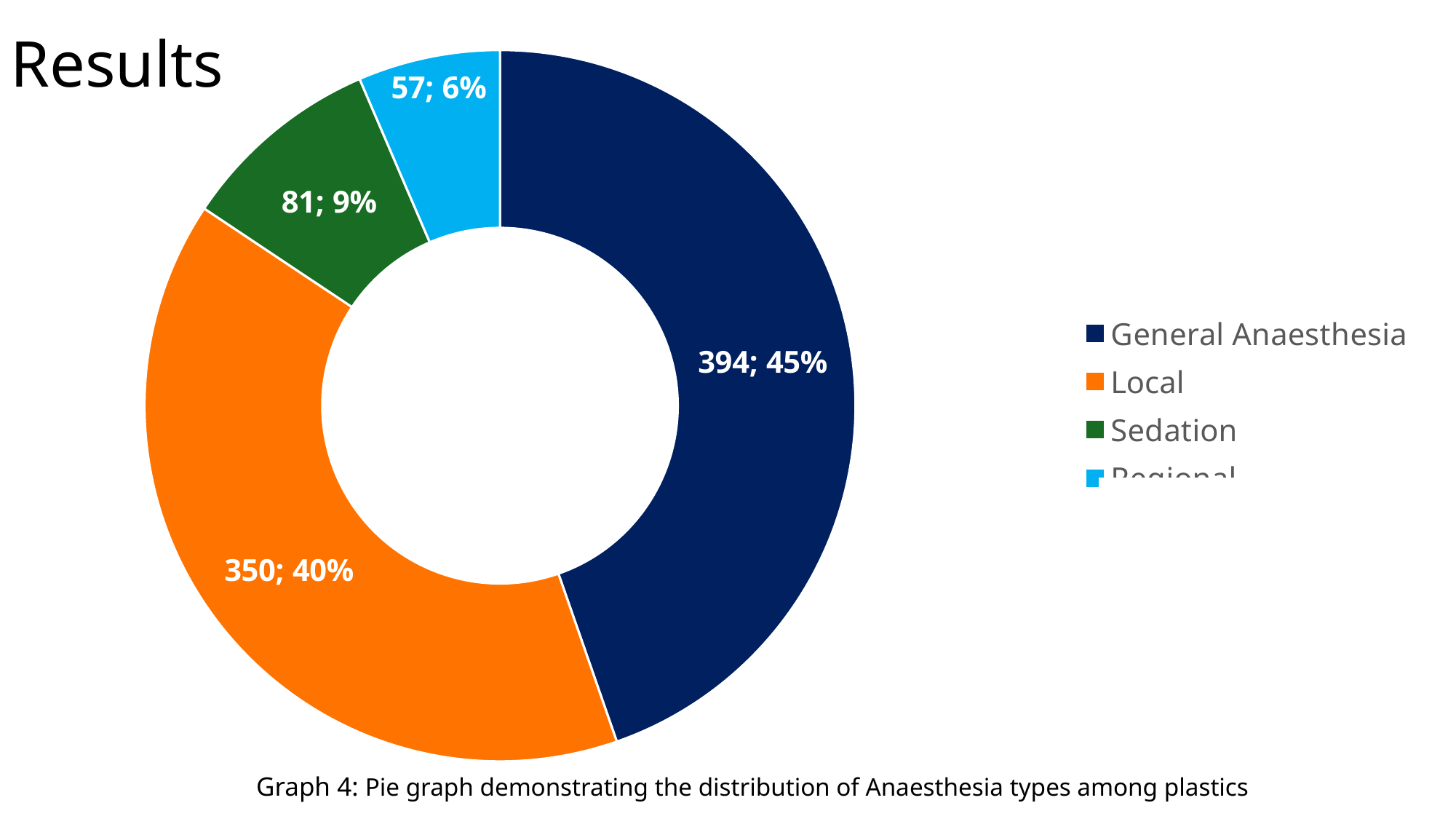
Which is larger, the value for Local or the value for Sedation? Local What is the caption given below the chart? Graph 4: Pie graph demonstrating the distribution of Anaesthesia types among plastics What is the smallest value labelled on the chart? 57 Which anaesthesia type has the largest slice of the pie? General Anaesthesia What is the difference between the General Anaesthesia count and the Local count? 44 What kind of chart is shown on the slide? Pie chart What percentage of the pie does Local account for? 40% What colour is the Local slice? Orange How many slices does the pie chart have? 4 How many cases are shown for General Anaesthesia? 394 What percentage share does Sedation have? 9% What is the value shown for Sedation? 81